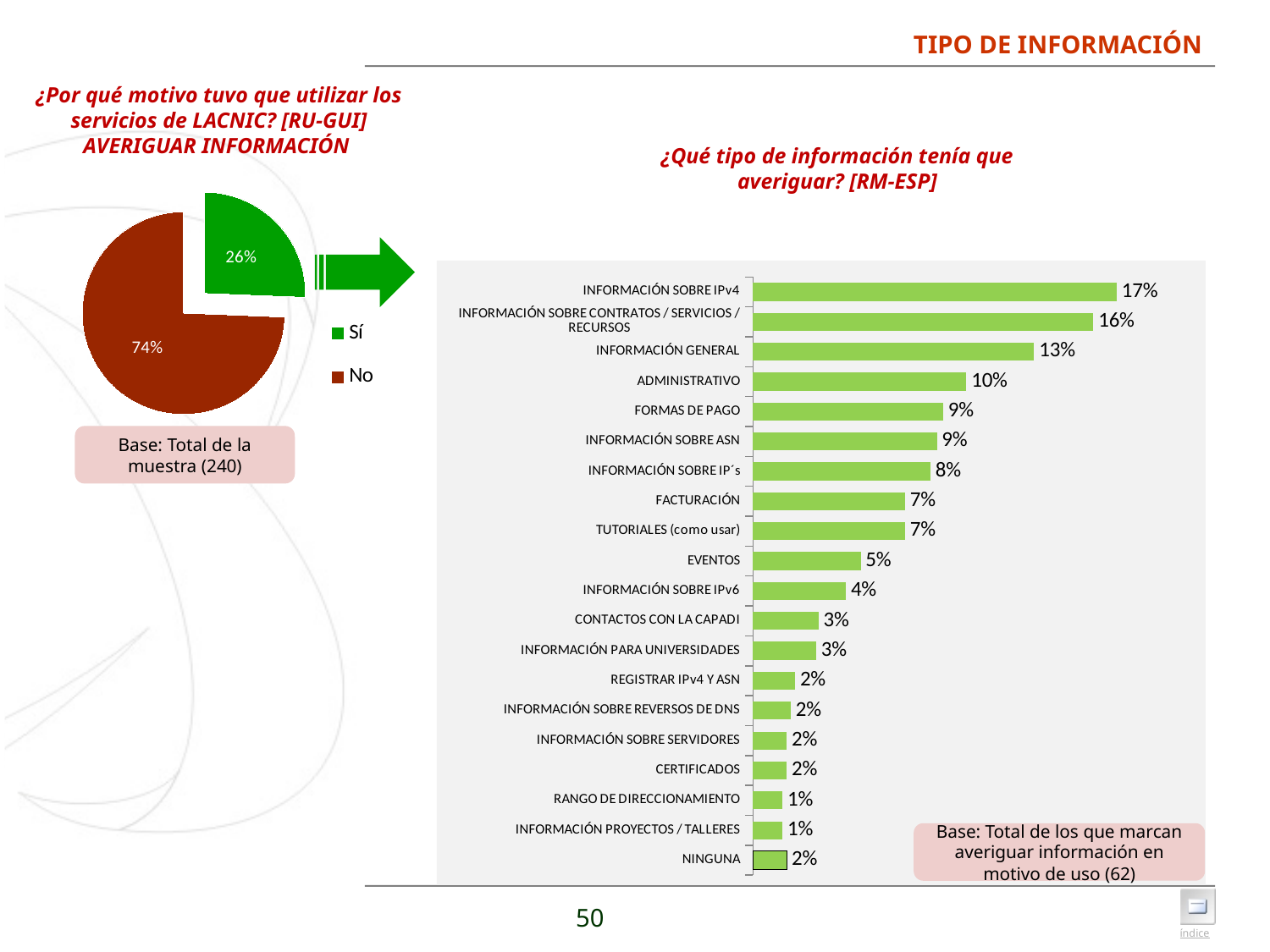
How many categories are shown in the bar chart on the right? 20 In the pie chart on the left, what percentage is shown for "No"? 74% In the bar chart on the right, which category has the highest value? INFORMACIÓN SOBRE IPv4 What kind of chart is the chart on the right titled "¿Qué tipo de información tenía que averiguar? [RM-ESP]"? Bar chart In the bar chart on the right, what is the difference between "INFORMACIÓN GENERAL" and "INFORMACIÓN SOBRE IPv6"? 9% In the pie chart on the left, which slice is larger, "Sí" or "No"? No How many entries does the legend of the pie chart on the left list? 2 In the bar chart on the right, what is the value for "NINGUNA"? 2% In the bar chart on the right, which is larger, "FORMAS DE PAGO" or "EVENTOS"? FORMAS DE PAGO In the pie chart on the left, what percentage is shown for "Sí"? 26% In the bar chart on the right, what is the value for "ADMINISTRATIVO"? 10% In the bar chart on the right, what is the value for "INFORMACIÓN SOBRE IPv4"? 17%